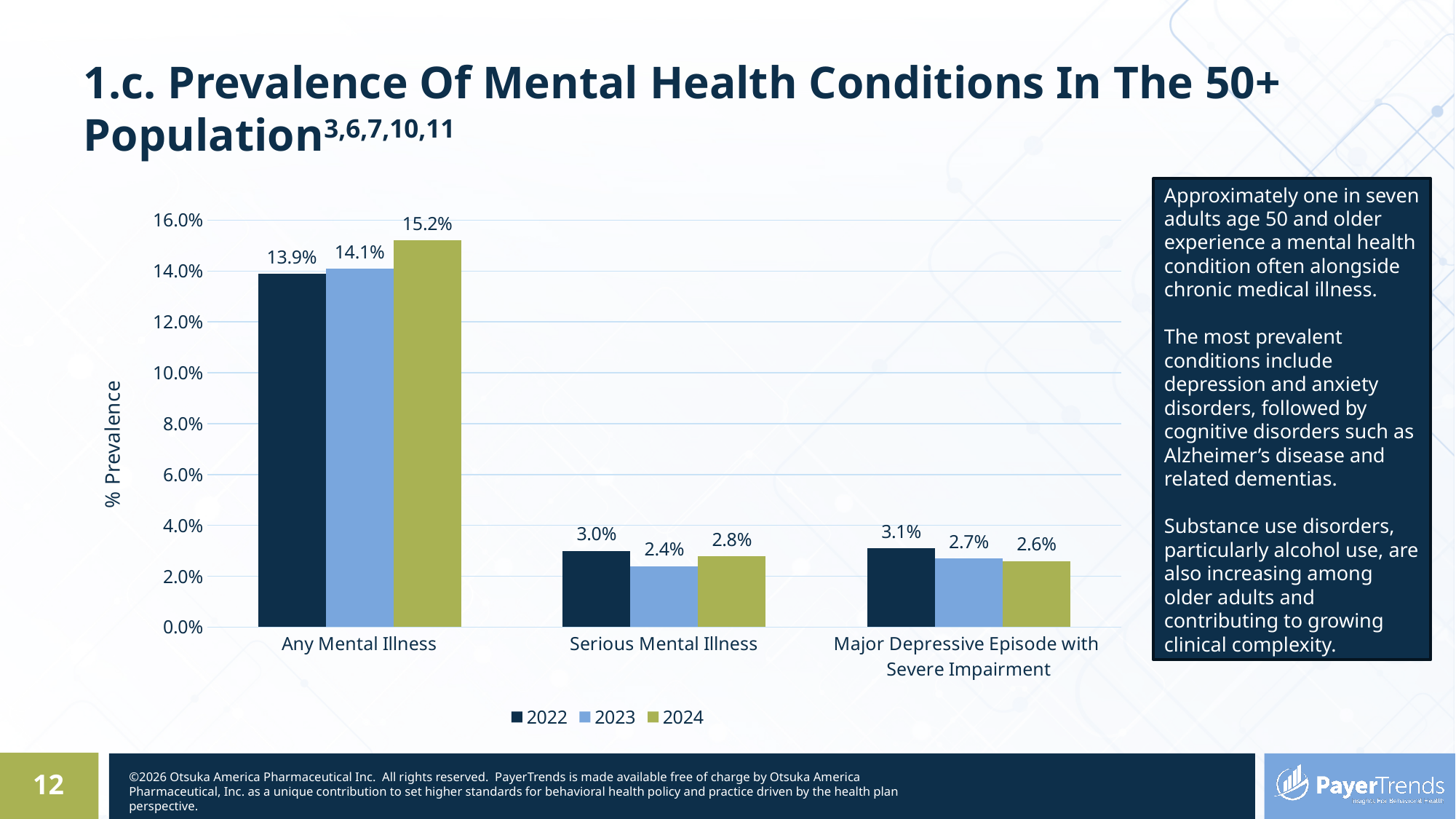
What is the label on the y axis of the chart? % Prevalence Which category has the lowest prevalence in 2024? Major Depressive Episode with Severe Impairment Does the prevalence of Any Mental Illness rise or fall from 2022 to 2024? Rise How many categories are shown on the x axis? 3 Which is larger: the 2023 prevalence of Serious Mental Illness or the 2023 prevalence of Major Depressive Episode with Severe Impairment? Major Depressive Episode with Severe Impairment What is the 2024 prevalence of Any Mental Illness? 15.2% What is the difference between the 2024 and 2022 prevalence of Any Mental Illness? 1.3% Which category has the highest prevalence in 2022? Any Mental Illness What kind of chart is shown on the slide? Bar chart What is the 2022 prevalence of Major Depressive Episode with Severe Impairment? 3.1% How many series does the legend list? 3 What is the 2023 prevalence of Serious Mental Illness? 2.4%